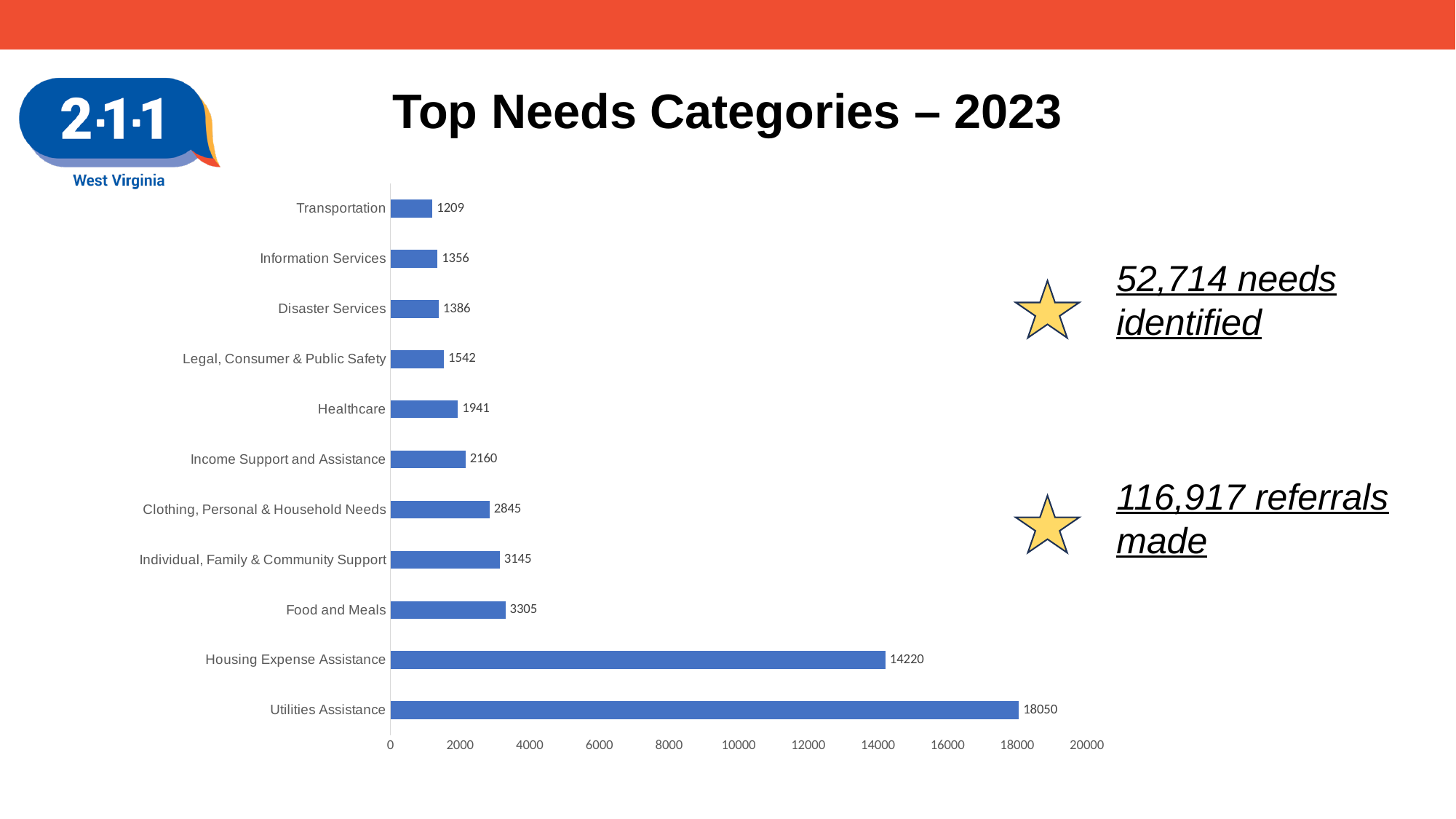
Which is larger, Food and Meals or Clothing, Personal & Household Needs? Food and Meals What is the difference between Income Support and Assistance and Transportation? 951 What is the value for Housing Expense Assistance? 14220 Is the value for Housing Expense Assistance greater or less than 12000? greater How many categories are shown in the chart? 11 What is the difference between Utilities Assistance and Housing Expense Assistance? 3830 Which category has the lowest value? Transportation What kind of chart is shown on the slide? Bar chart What is the value for Healthcare? 1941 What is the title of the chart on the slide? Top Needs Categories – 2023 What is the value for Utilities Assistance? 18050 Which category has the highest value? Utilities Assistance